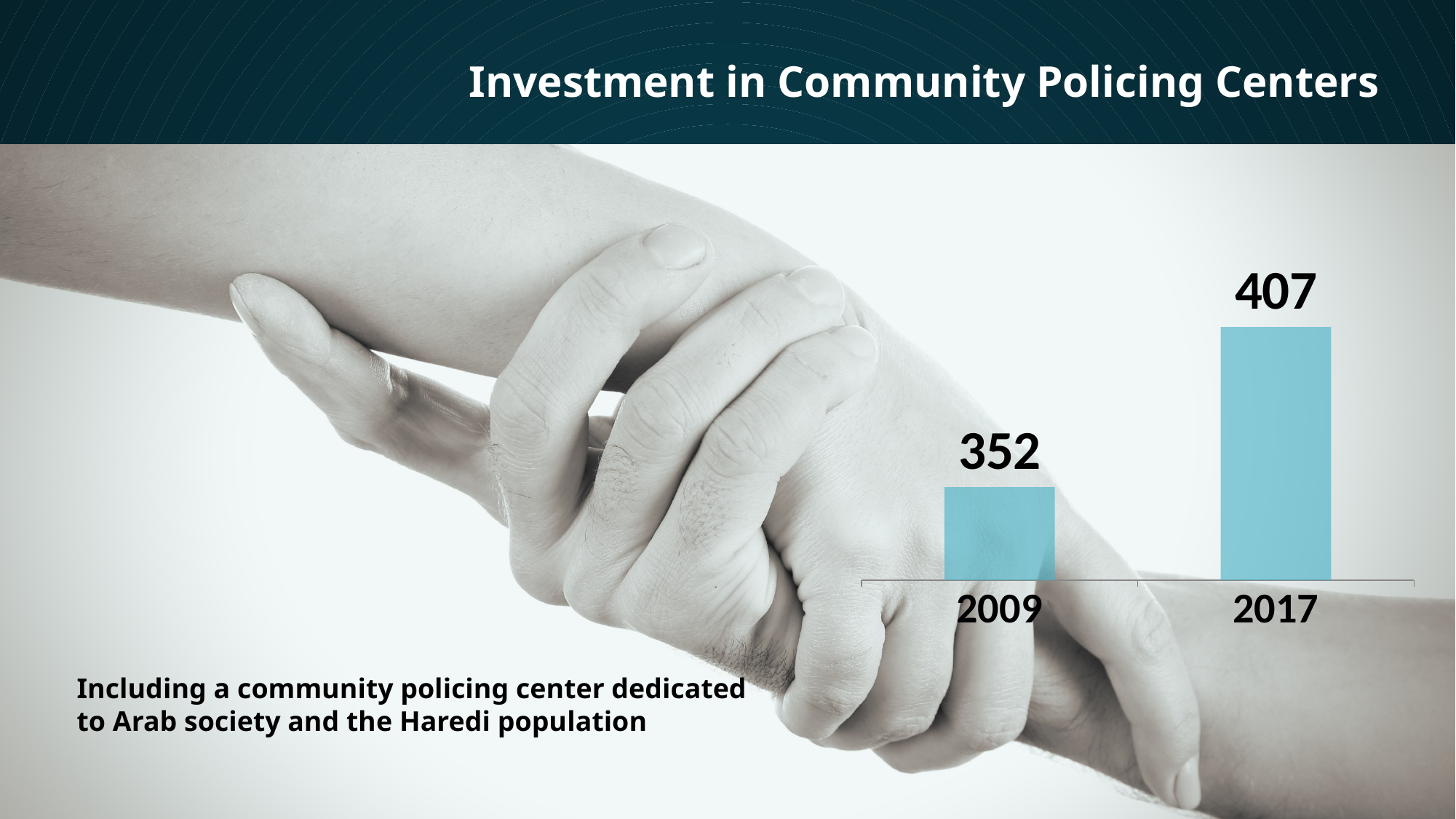
What is the value for 2017? 407 Which is larger, the value for 2009 or the value for 2017? 2017 What is the value for 2009? 352 Do the values rise or fall from 2009 to 2017? rise Which year has the lowest value? 2009 How many categories are shown on the x axis? 2 What is the title of the slide containing the chart? Investment in Community Policing Centers Which year has the highest value? 2017 What kind of chart is shown on the slide? bar chart What colour are the bars in the chart? light blue What is the difference between the values for 2017 and 2009? 55